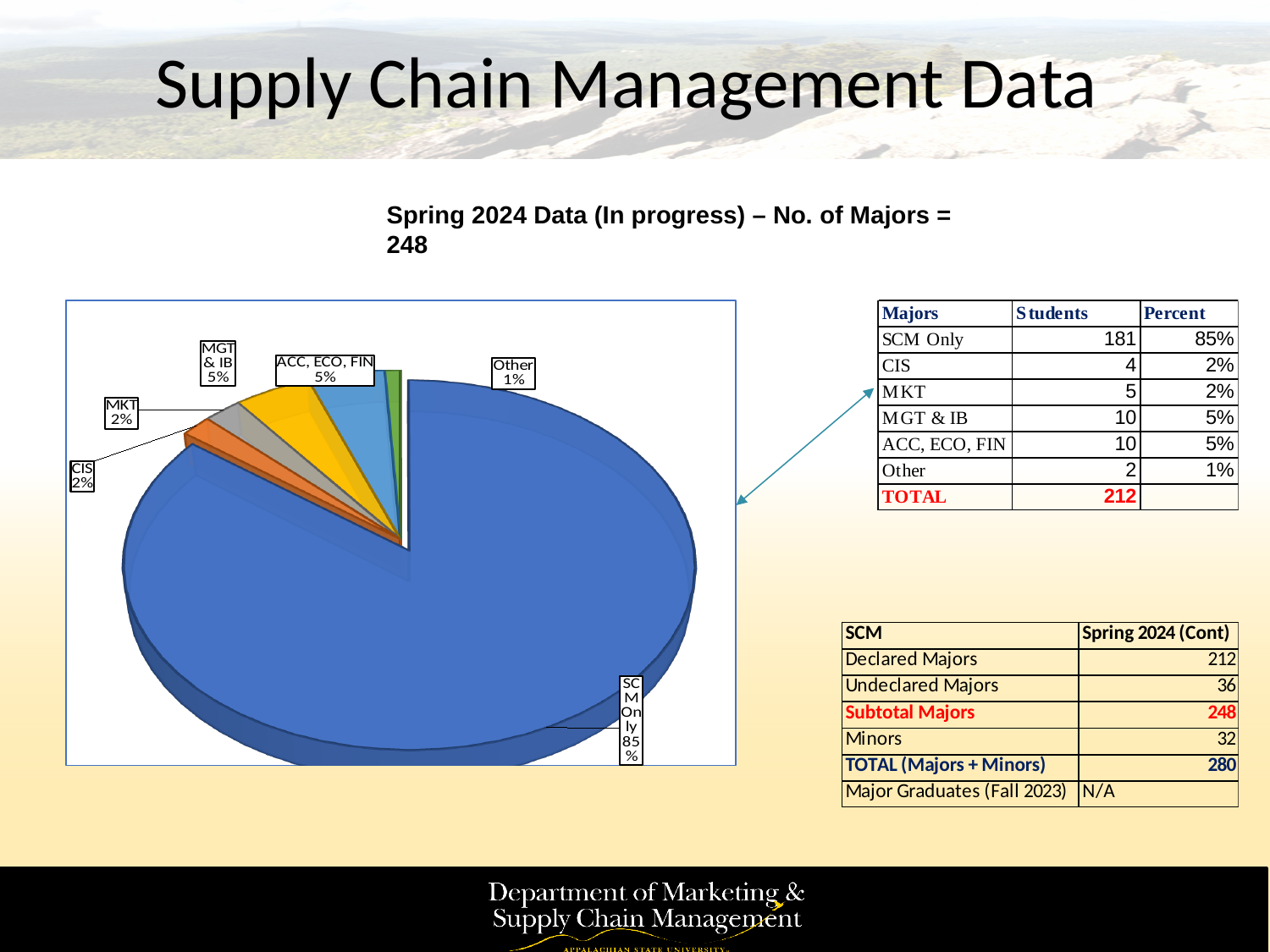
What percentage is shown for the MGT & IB slice in the pie chart? 5% Which is larger in the pie chart, the MGT & IB slice or the CIS slice? MGT & IB What kind of chart is shown on the slide? pie chart Which slice of the pie chart is the smallest? Other How many slices does the pie chart have? 6 What share of the pie does the SCM Only slice represent? 85% What percentage is shown for the ACC, ECO, FIN slice in the pie chart? 5% What percentage is shown for the MKT slice in the pie chart? 2% Which slice of the pie chart is the largest? SCM Only What percentage is shown for the CIS slice in the pie chart? 2% What percentage is shown for the Other slice in the pie chart? 1% What is the difference in percentage points between the SCM Only slice and the ACC, ECO, FIN slice? 80